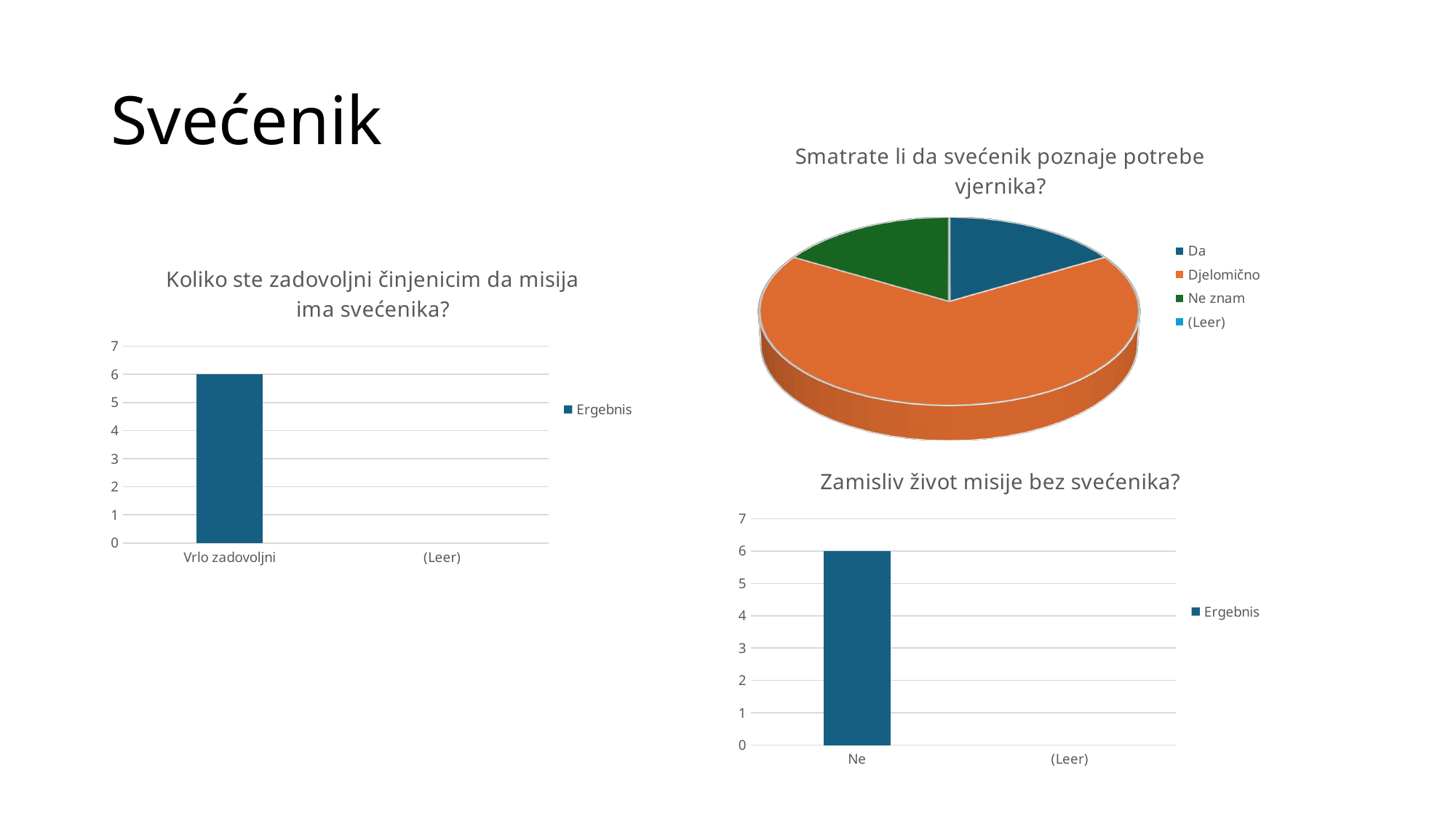
In the chart titled "Koliko ste zadovoljni činjenicim da misija ima svećenika?", which category has the highest value? Vrlo zadovoljni In the chart titled "Zamisliv život misije bez svećenika?", what is the value for Ne? 6 How many series does the legend of the chart titled "Zamisliv život misije bez svećenika?" list? 1 In the chart titled "Zamisliv život misije bez svećenika?", is the value for Ne greater or less than 5? greater In the chart titled "Zamisliv život misije bez svećenika?", which category has the highest value? Ne What is the name of the series in the legend of the chart titled "Koliko ste zadovoljni činjenicim da misija ima svećenika?"? Ergebnis What kind of chart is the chart titled "Smatrate li da svećenik poznaje potrebe vjernika?"? pie chart In the pie chart titled "Smatrate li da svećenik poznaje potrebe vjernika?", which is larger, Da or Djelomično? Djelomično How many categories are shown on the x axis of the chart titled "Koliko ste zadovoljni činjenicim da misija ima svećenika?"? 2 How many categories are listed in the legend of the pie chart titled "Smatrate li da svećenik poznaje potrebe vjernika?"? 4 In the chart titled "Koliko ste zadovoljni činjenicim da misija ima svećenika?", what is the value for Vrlo zadovoljni? 6 In the pie chart titled "Smatrate li da svećenik poznaje potrebe vjernika?", which category has the largest slice? Djelomično